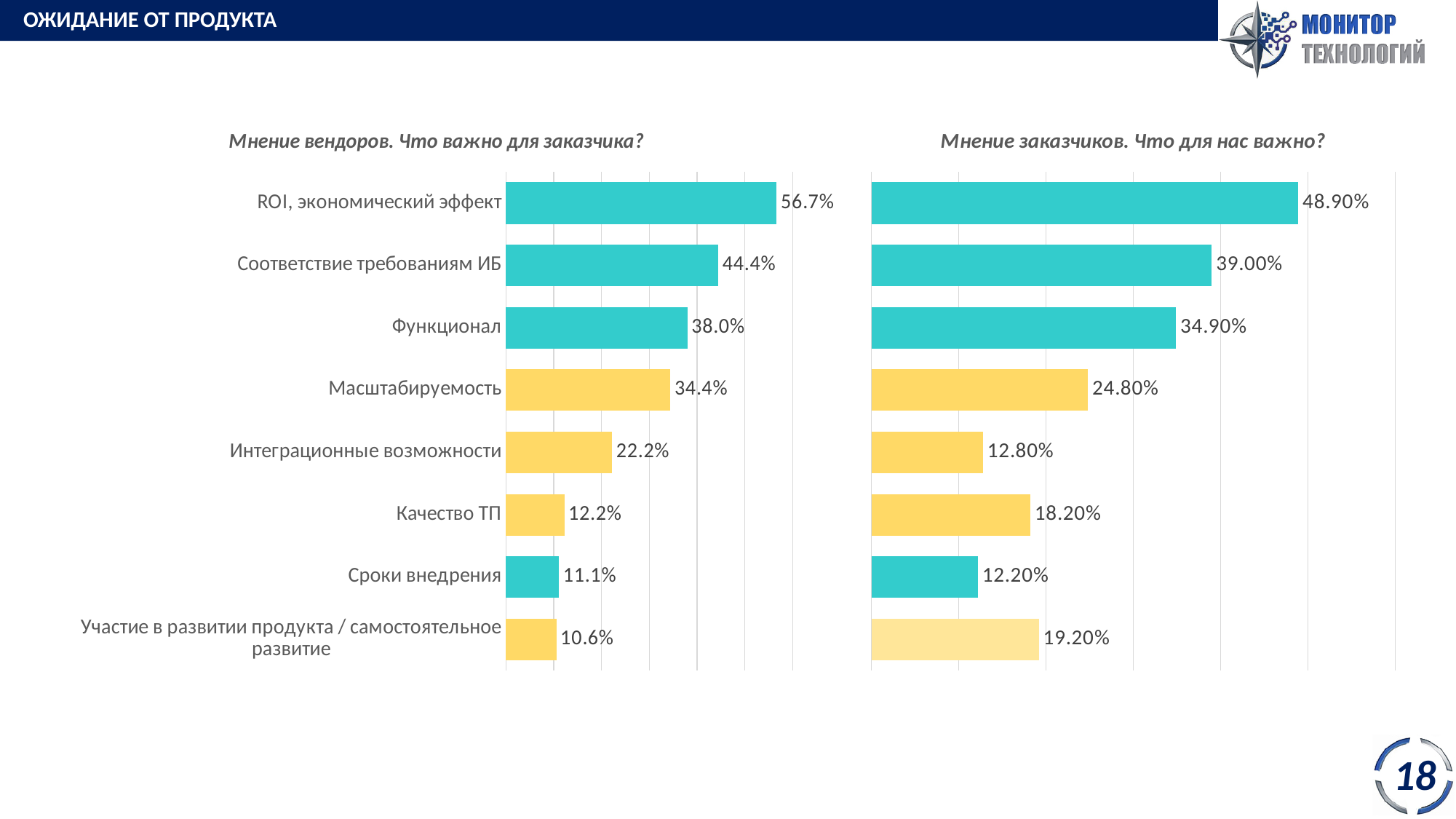
In the chart titled "Мнение заказчиков. Что для нас важно?", which is larger: "Качество ТП" or "Интеграционные возможности"? Качество ТП How many categories are shown in the chart titled "Мнение вендоров. Что важно для заказчика?"? 8 In the chart titled "Мнение вендоров. Что важно для заказчика?", what is the difference between "ROI, экономический эффект" and "Соответствие требованиям ИБ"? 12.3% What type of chart is the chart titled "Мнение заказчиков. Что для нас важно?"? Bar chart In the chart titled "Мнение вендоров. Что важно для заказчика?", what is the value for "ROI, экономический эффект"? 56.7% In the chart titled "Мнение заказчиков. Что для нас важно?", what is the value for "Масштабируемость"? 24.80% In the chart titled "Мнение заказчиков. Что для нас важно?", which category has the highest value? ROI, экономический эффект In the chart titled "Мнение заказчиков. Что для нас важно?", what is the difference between "Функционал" and "Интеграционные возможности"? 22.10% In the chart titled "Мнение заказчиков. Что для нас важно?", which category has the lowest value? Сроки внедрения In the chart titled "Мнение вендоров. Что важно для заказчика?", which is larger: "Функционал" or "Масштабируемость"? Функционал In the chart titled "Мнение заказчиков. Что для нас важно?", what is the value for "Качество ТП"? 18.20% In the chart titled "Мнение вендоров. Что важно для заказчика?", which category has the lowest value? Участие в развитии продукта / самостоятельное развитие